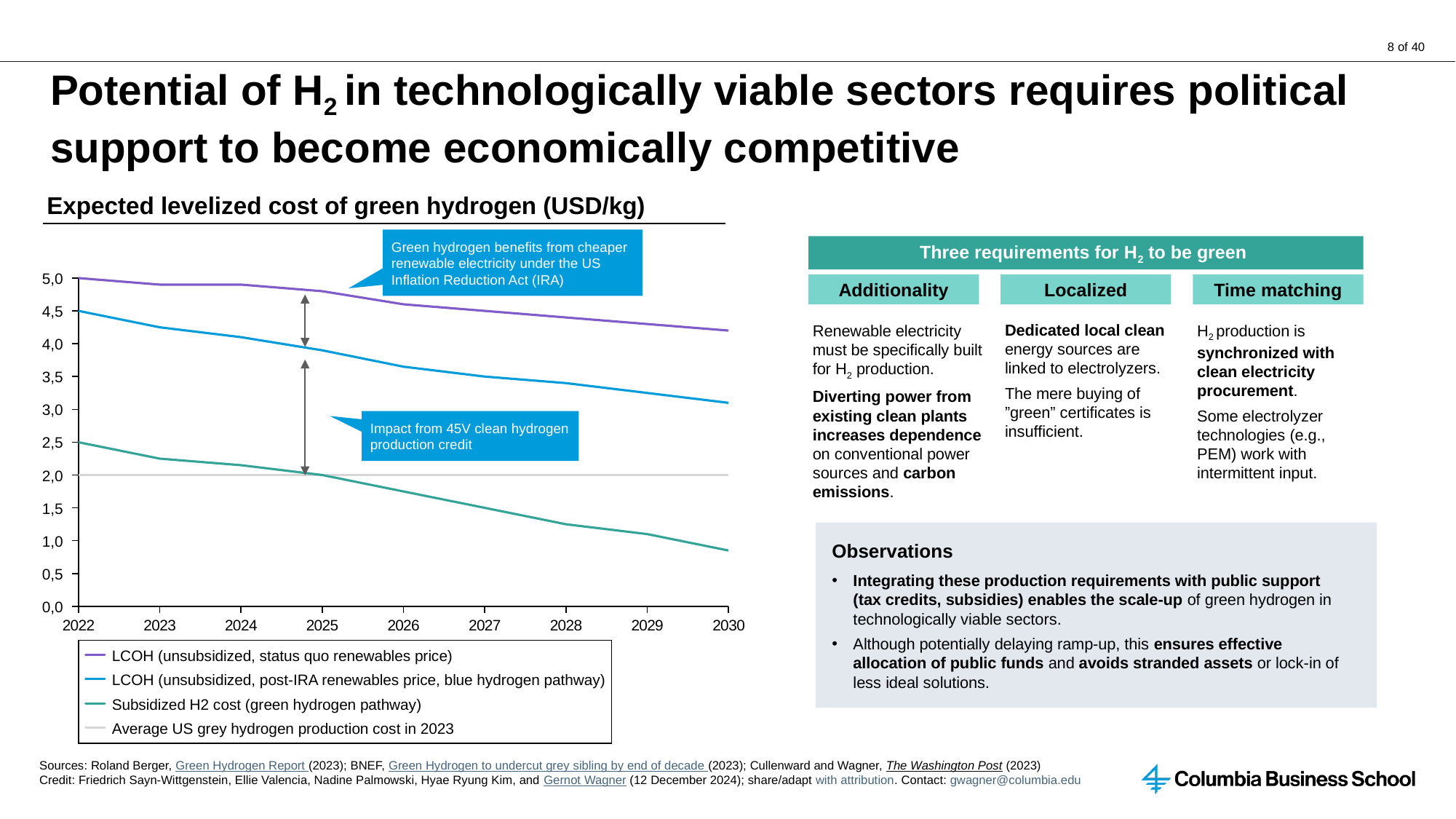
Which series has the lowest value in 2030? Subsidized H2 cost (green hydrogen pathway) Does the 'Subsidized H2 cost (green hydrogen pathway)' series rise or fall from 2022 to 2030? fall Which series has the highest value in 2022? LCOH (unsubsidized, status quo renewables price) Is the value for 'Subsidized H2 cost (green hydrogen pathway)' in 2030 greater or less than 1,0? less What value does the 'Average US grey hydrogen production cost in 2023' line sit at? 2,0 How many years are shown along the x axis of the chart? 9 What is the first year shown on the x axis of the chart? 2022 Is the value for 'LCOH (unsubsidized, status quo renewables price)' in 2030 greater or less than 4,0? greater In 2026, which is larger: 'LCOH (unsubsidized, post-IRA renewables price, blue hydrogen pathway)' or 'Subsidized H2 cost (green hydrogen pathway)'? LCOH (unsubsidized, post-IRA renewables price, blue hydrogen pathway) How many series does the legend of the chart list? 4 Is the value for 'LCOH (unsubsidized, post-IRA renewables price, blue hydrogen pathway)' in 2030 greater or less than 3,0? greater What kind of chart is shown under the heading 'Expected levelized cost of green hydrogen (USD/kg)'? line chart